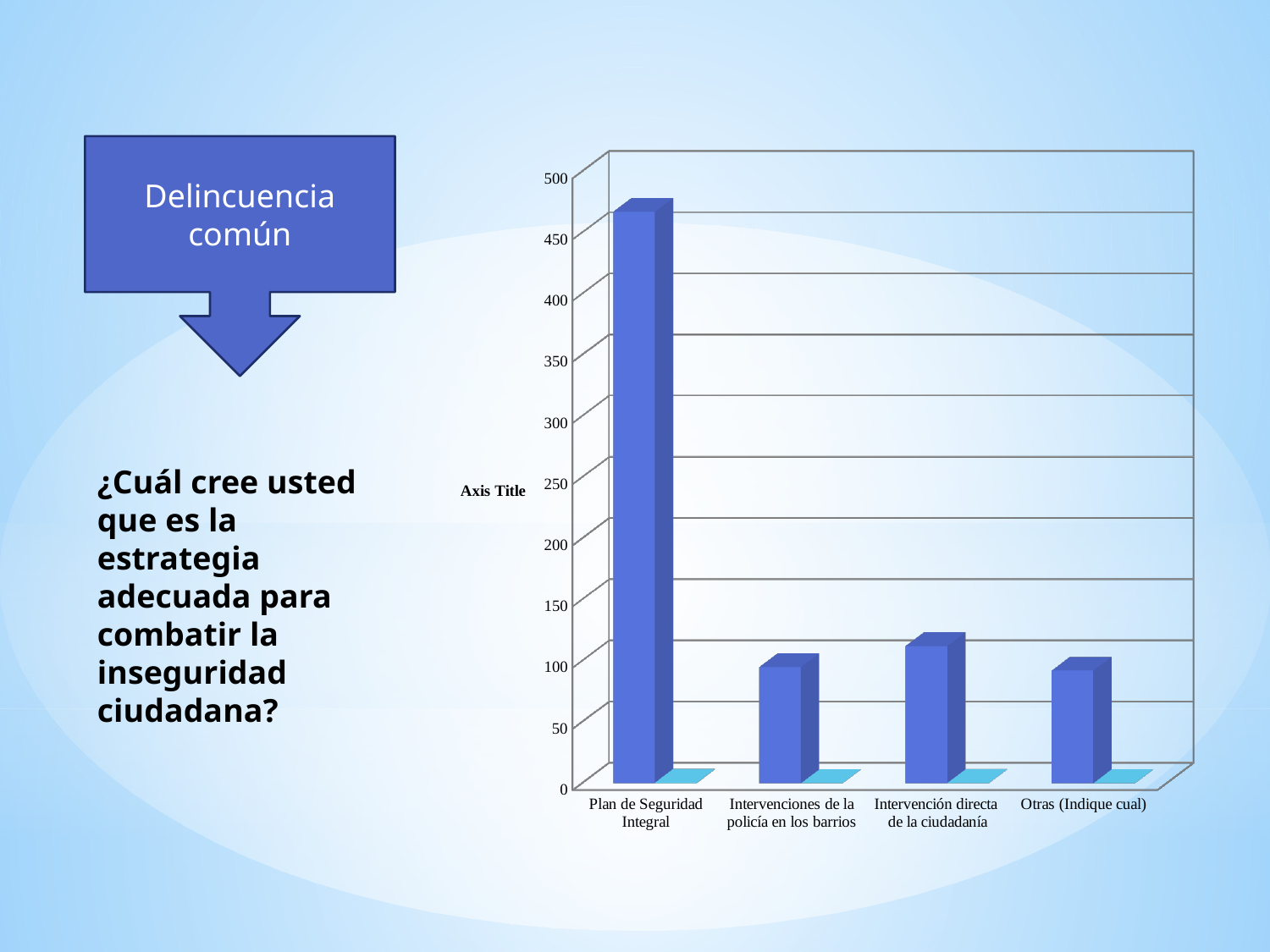
What is the highest tick value shown on the vertical axis of the chart? 500 What kind of chart is shown on the slide? bar chart How many categories are shown on the x axis of the chart? 4 Is the value for Intervención directa de la ciudadanía greater or less than 200? less Which category has the highest value in the chart? Plan de Seguridad Integral Is the value for Plan de Seguridad Integral greater or less than 400? greater Which is larger, the value for Intervención directa de la ciudadanía or the value for Otras (Indique cual)? Intervención directa de la ciudadanía What is the label shown on the vertical axis of the chart? Axis Title Is the value for Intervenciones de la policía en los barrios greater or less than 150? less Which is larger, the value for Plan de Seguridad Integral or the value for Intervención directa de la ciudadanía? Plan de Seguridad Integral